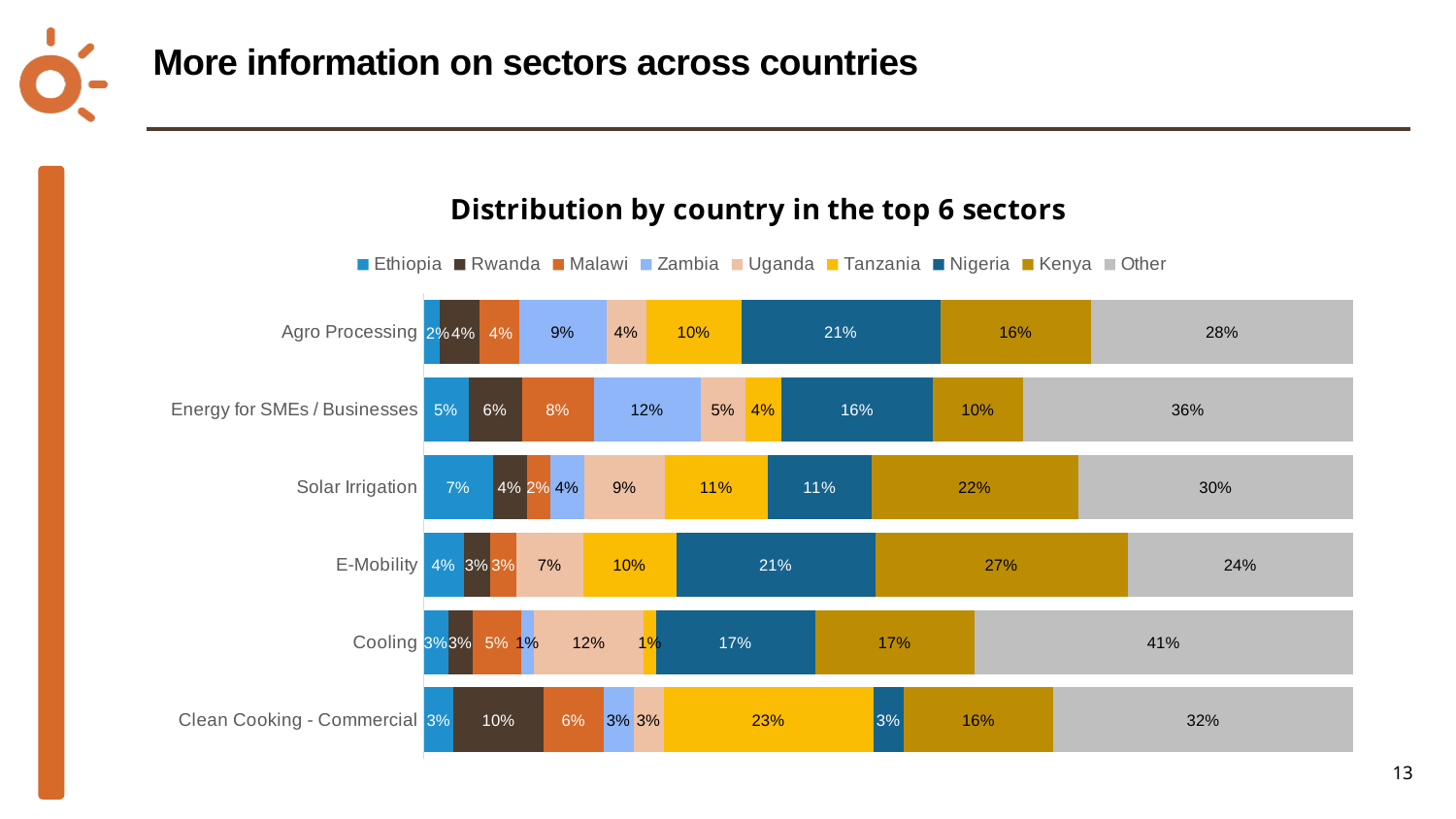
What kind of chart is shown on the slide? Stacked bar chart What is the value for Kenya in the E-Mobility bar? 27% What is the value for Tanzania in the Clean Cooking - Commercial bar? 23% What is the value for Other in the Cooling bar? 41% What is the value for Zambia in the Energy for SMEs / Businesses bar? 12% What is the difference between the Other value for Cooling and the Other value for Agro Processing? 13% How many sectors are shown in the chart? 6 Which sector has the highest value for Kenya? E-Mobility Which is larger: the Nigeria value for Solar Irrigation or the Nigeria value for E-Mobility? E-Mobility How many series does the legend list? 9 What is the value for Nigeria in the Agro Processing bar? 21% Which sector has the lowest value for Other? E-Mobility